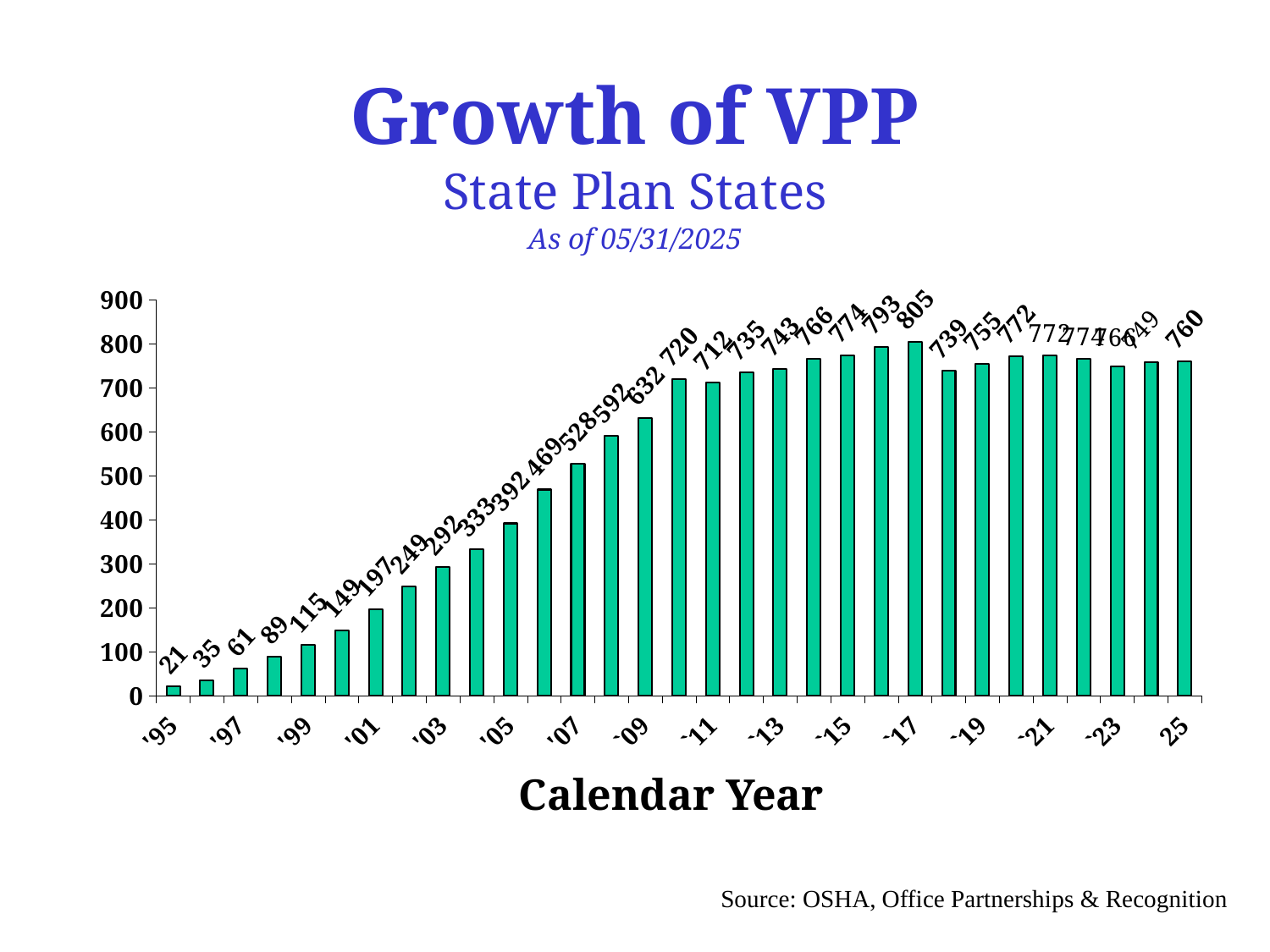
How many bars are plotted in the chart? 31 What is the difference between the values for '17 and '18? 66 What is the value for '95? 21 What is the value for '05? 392 Which is larger, the value for '10 or the value for '11? '10 Which year has the highest value? '17 Is the value for '07 greater or less than 500? greater What is the title of the x axis? Calendar Year What kind of chart is shown on the slide? bar chart What is the value for '17? 805 What is the value for '25? 760 Which year has the lowest value? '95